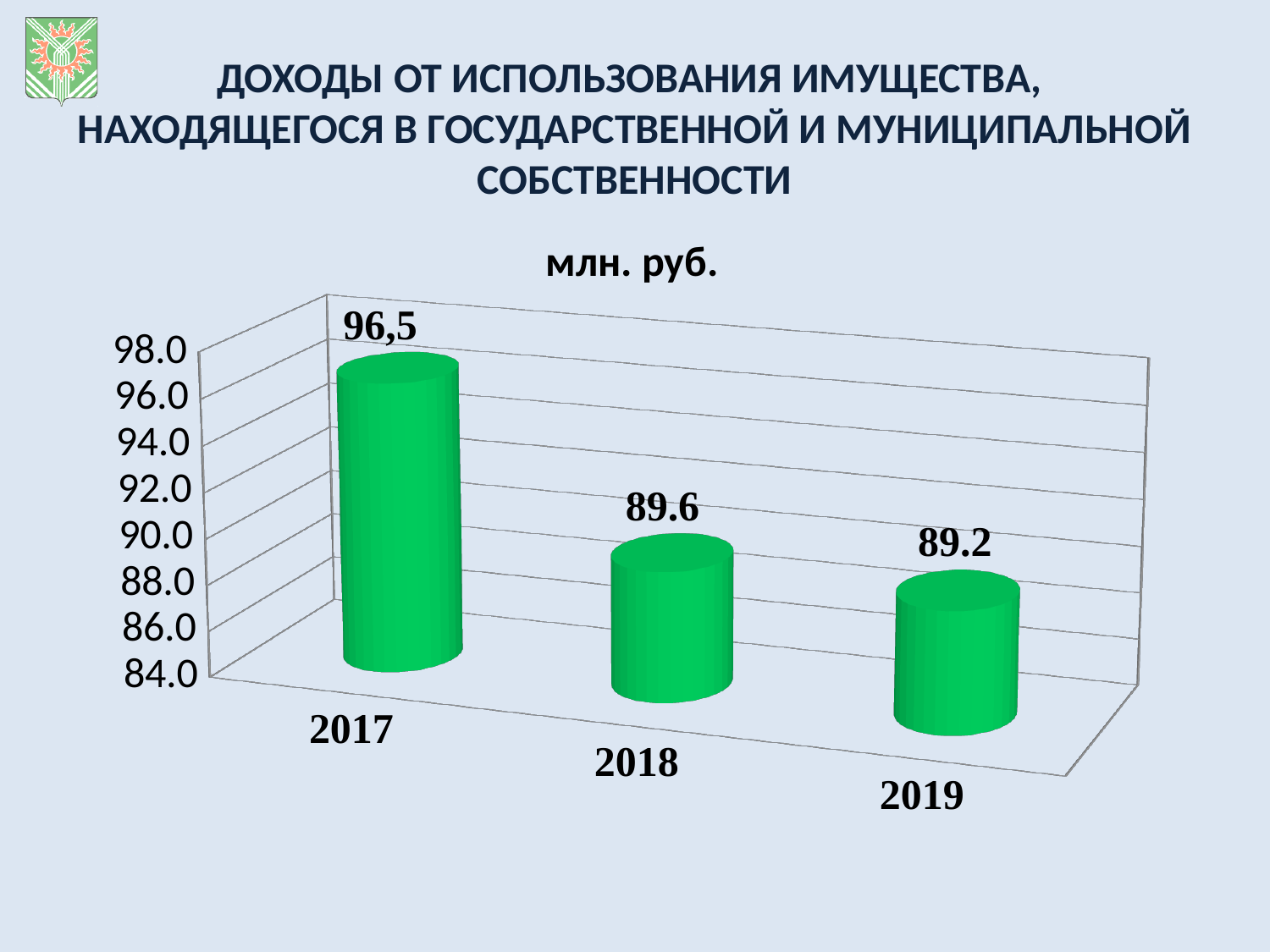
What is the value for 2017? 96,5 What is the value for 2019? 89.2 What is the value for 2018? 89.6 How many years are shown on the chart? 3 Which is larger, the value for 2017 or the value for 2018? 2017 Is the value for 2019 greater or less than 90.0? less Which year has the highest value? 2017 Which year has the lowest value? 2019 Do the values rise or fall from 2017 to 2019? fall What kind of chart is shown on the slide? bar chart What unit is given in the chart title? млн. руб. What is the difference between the values for 2018 and 2019? 0.4